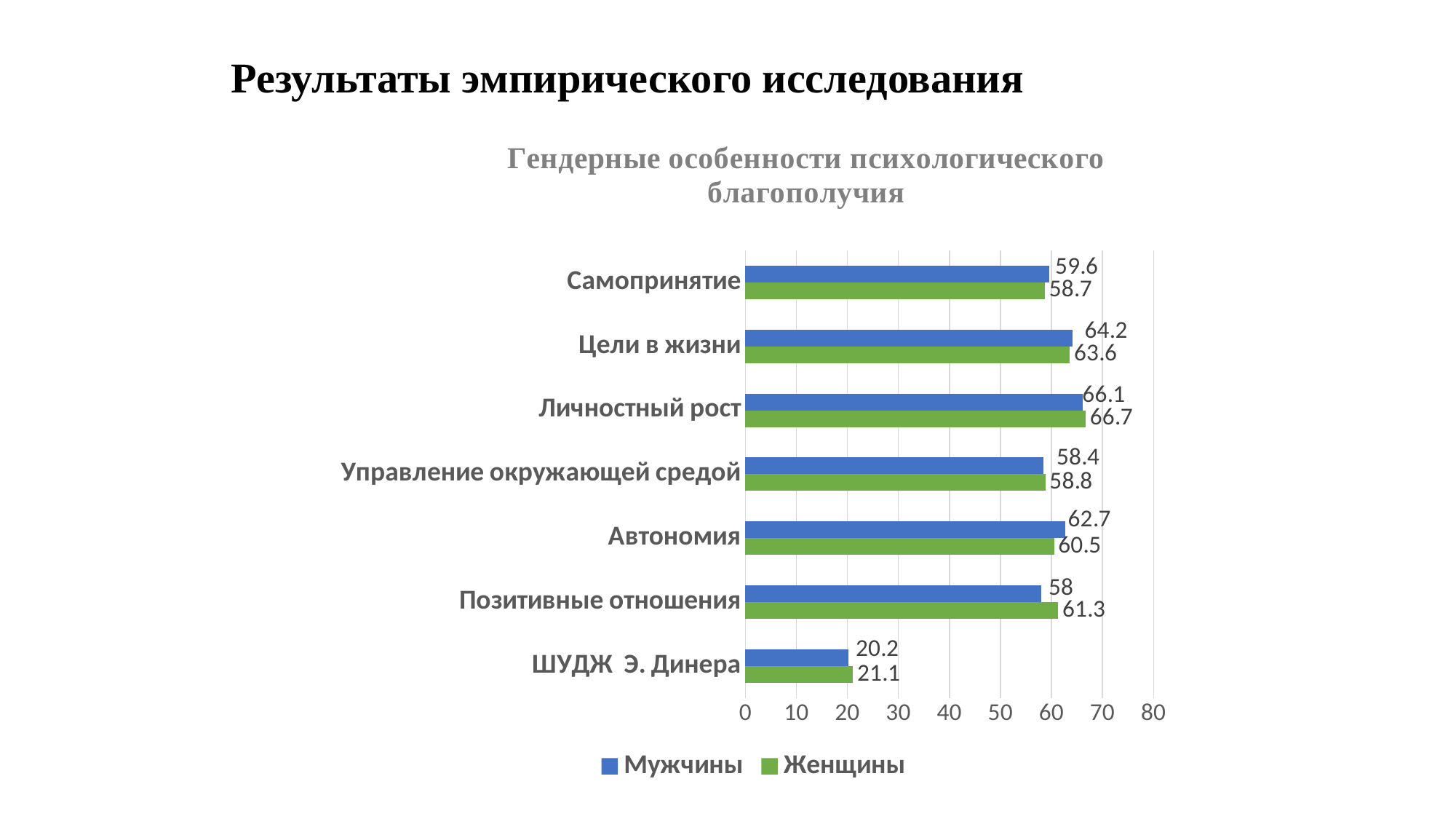
Which is larger for Цели в жизни: the value for Мужчины or for Женщины? Мужчины What is the value for Женщины in the Личностный рост category? 66.7 What is the title of the chart? Гендерные особенности психологического благополучия What is the difference between the Мужчины and Женщины values for Автономия? 2.2 What is the value for Мужчины in the Самопринятие category? 59.6 What kind of chart is shown on the slide? Bar chart What is the difference between the Женщины and Мужчины values for Позитивные отношения? 3.3 How many series does the legend list? 2 What is the value for Женщины in the Позитивные отношения category? 61.3 Which category has the highest value for Женщины? Личностный рост Which category has the lowest value for Мужчины? ШУДЖ Э. Динера How many categories are shown on the chart? 7